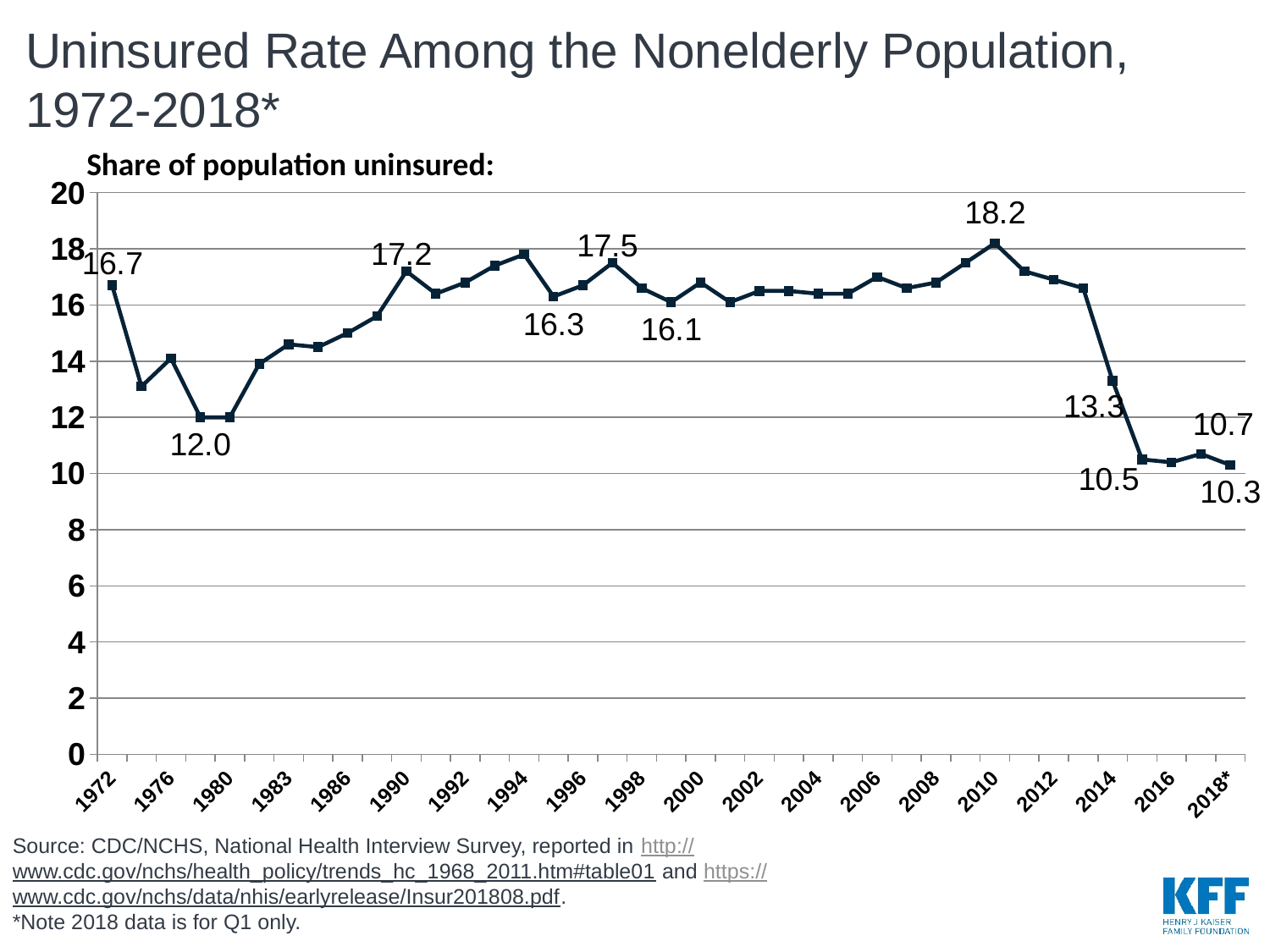
In which year is the uninsured rate at its lowest value? 2018* What is the uninsured rate shown for 2014? 13.3 In which year does the uninsured rate reach its highest value? 2010 What is the difference between the highest value (18.2) and the lowest value (10.3)? 7.9 What is the uninsured rate shown for 2018*? 10.3 Does the uninsured rate rise or fall from 2010 to 2018*? fall What type of chart is shown on the slide? line chart What is the uninsured rate shown for 1972? 16.7 What is the difference between the 2014 value (13.3) and the 2015 value (10.5)? 2.8 Which year has the higher uninsured rate, 1972 or 2010? 2010 What is the uninsured rate shown for 2010? 18.2